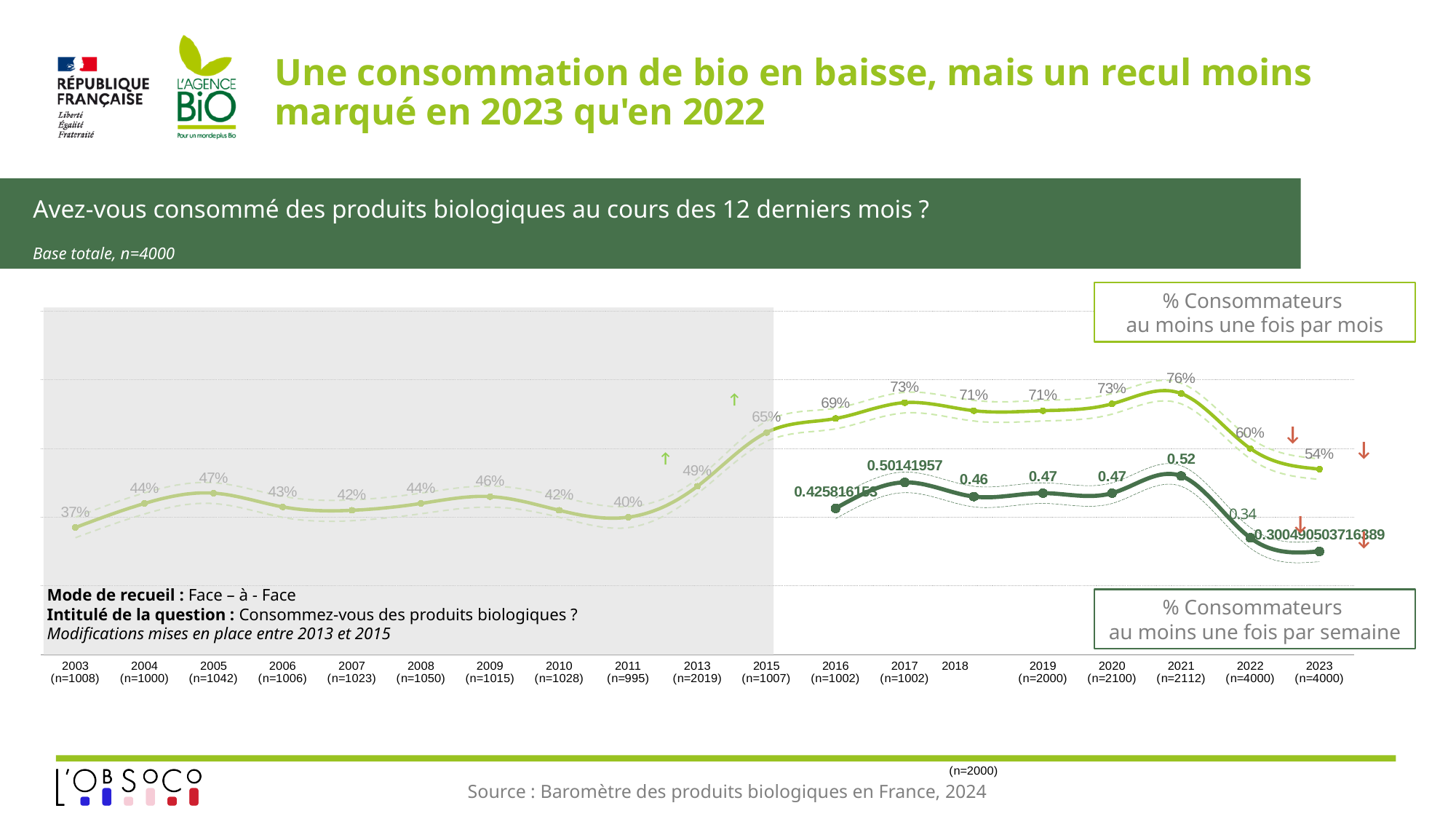
Which is larger in the '% Consommateurs au moins une fois par mois' series: the value for 2015 or the value for 2013? 2015 What is the value for 2021 in the '% Consommateurs au moins une fois par mois' series? 76% How many series does the chart show? 2 What is the value for 2022 in the '% Consommateurs au moins une fois par semaine' series? 0.34 What is the value for 2023 in the '% Consommateurs au moins une fois par mois' series? 54% In which year is the '% Consommateurs au moins une fois par mois' series at its lowest value? 2003 How does the '% Consommateurs au moins une fois par mois' series change from 2021 to 2023? It falls In which year does the '% Consommateurs au moins une fois par mois' series reach its highest value? 2021 What is the value for 2021 in the '% Consommateurs au moins une fois par semaine' series? 0.52 What is the value for 2003 in the '% Consommateurs au moins une fois par mois' series? 37% What is the difference between the 2021 and 2022 values in the '% Consommateurs au moins une fois par mois' series? 16 percentage points What type of chart is shown on the slide? line chart